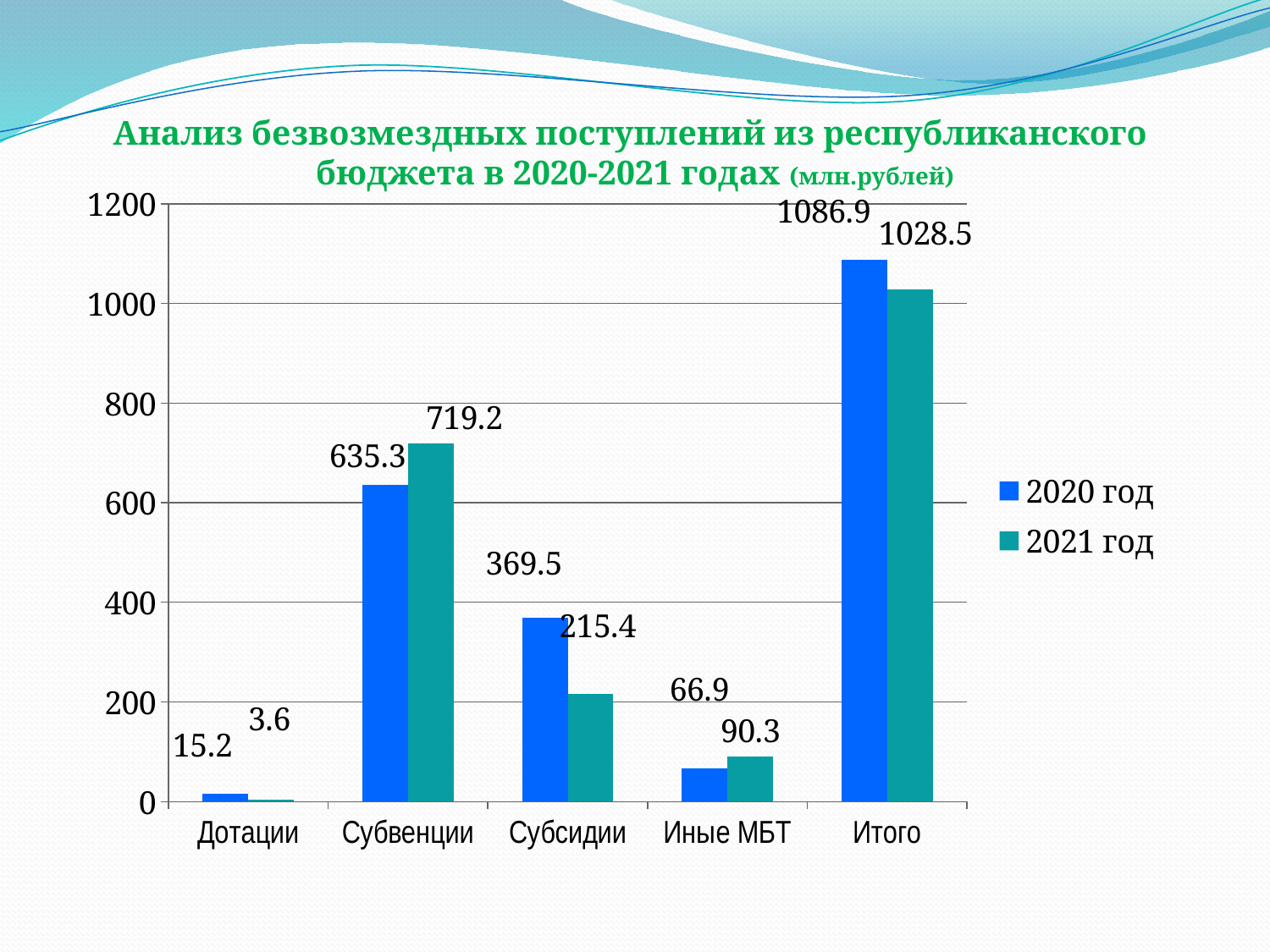
How many series does the legend list? 2 Which is larger for Иные МБТ: the 2020 год value or the 2021 год value? 2021 год Which category has the highest value in the 2020 год series? Итого What is the value for Дотации in the 2021 год series? 3.6 How many categories are shown on the x axis? 5 Excluding Итого, which category has the lowest value in the 2021 год series? Дотации What is the value for Субвенции in the 2021 год series? 719.2 What is the value for Субсидии in the 2020 год series? 369.5 What kind of chart is shown on the slide? Bar chart Is the 2021 год value for Субвенции greater or less than 600? greater What is the difference between the 2020 год and 2021 год values for Субсидии? 154.1 What is the value for Иные МБТ in the 2020 год series? 66.9